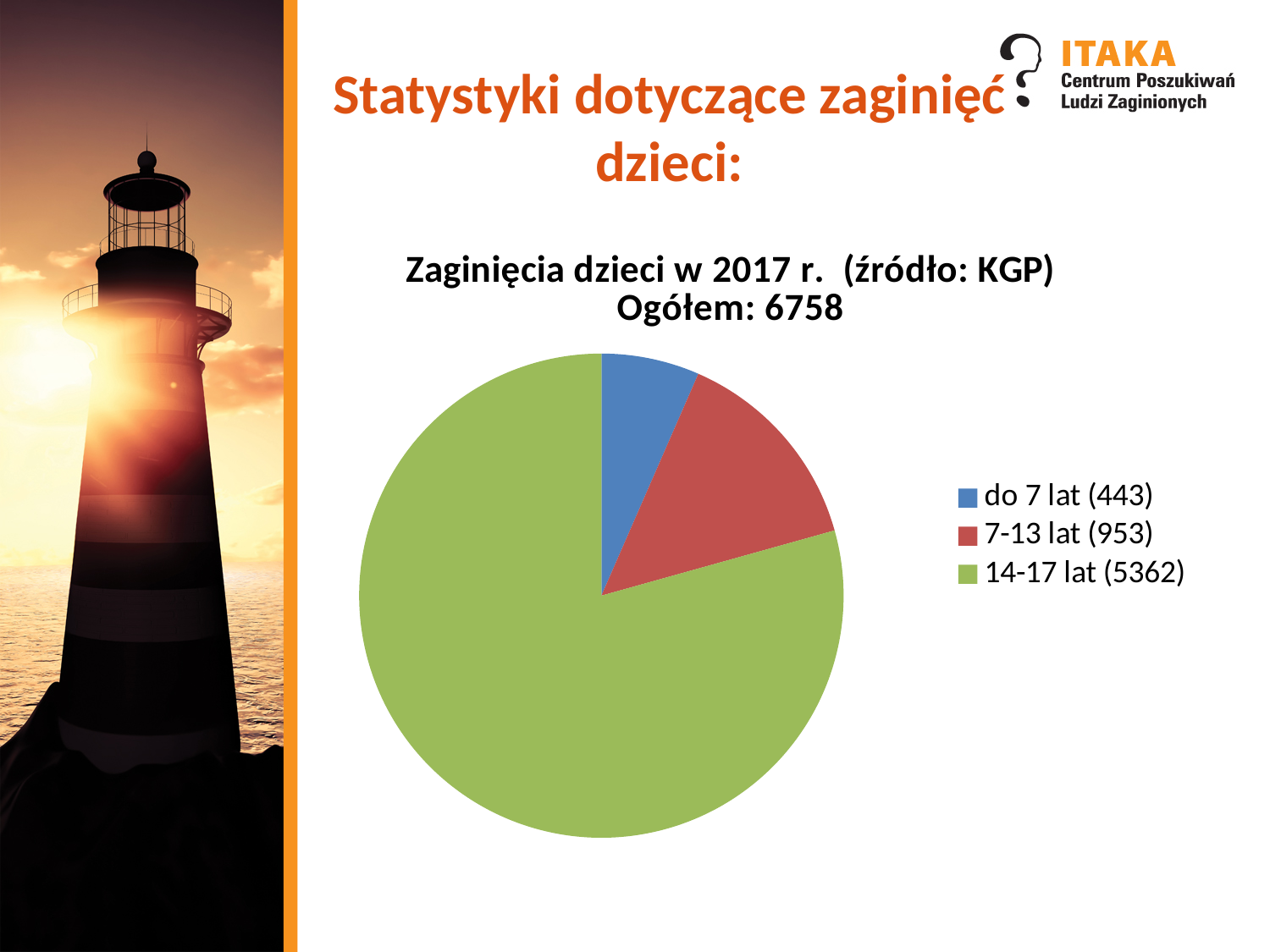
What colour is the slice for '14-17 lat'? green Which category has the smallest slice of the pie? do 7 lat Which is larger, the value for '7-13 lat' or the value for 'do 7 lat'? 7-13 lat What is the value for the category '14-17 lat'? 5362 What type of chart is shown on the slide? pie chart What is the value for the category '7-13 lat'? 953 What is the difference between the values for '14-17 lat' and '7-13 lat'? 4409 Which category has the largest slice of the pie? 14-17 lat What is the title of the chart? Zaginięcia dzieci w 2017 r. (źródło: KGP) Ogółem: 6758 What is the value for the category 'do 7 lat'? 443 How many categories does the pie chart show? 3 What is the difference between the values for '7-13 lat' and 'do 7 lat'? 510